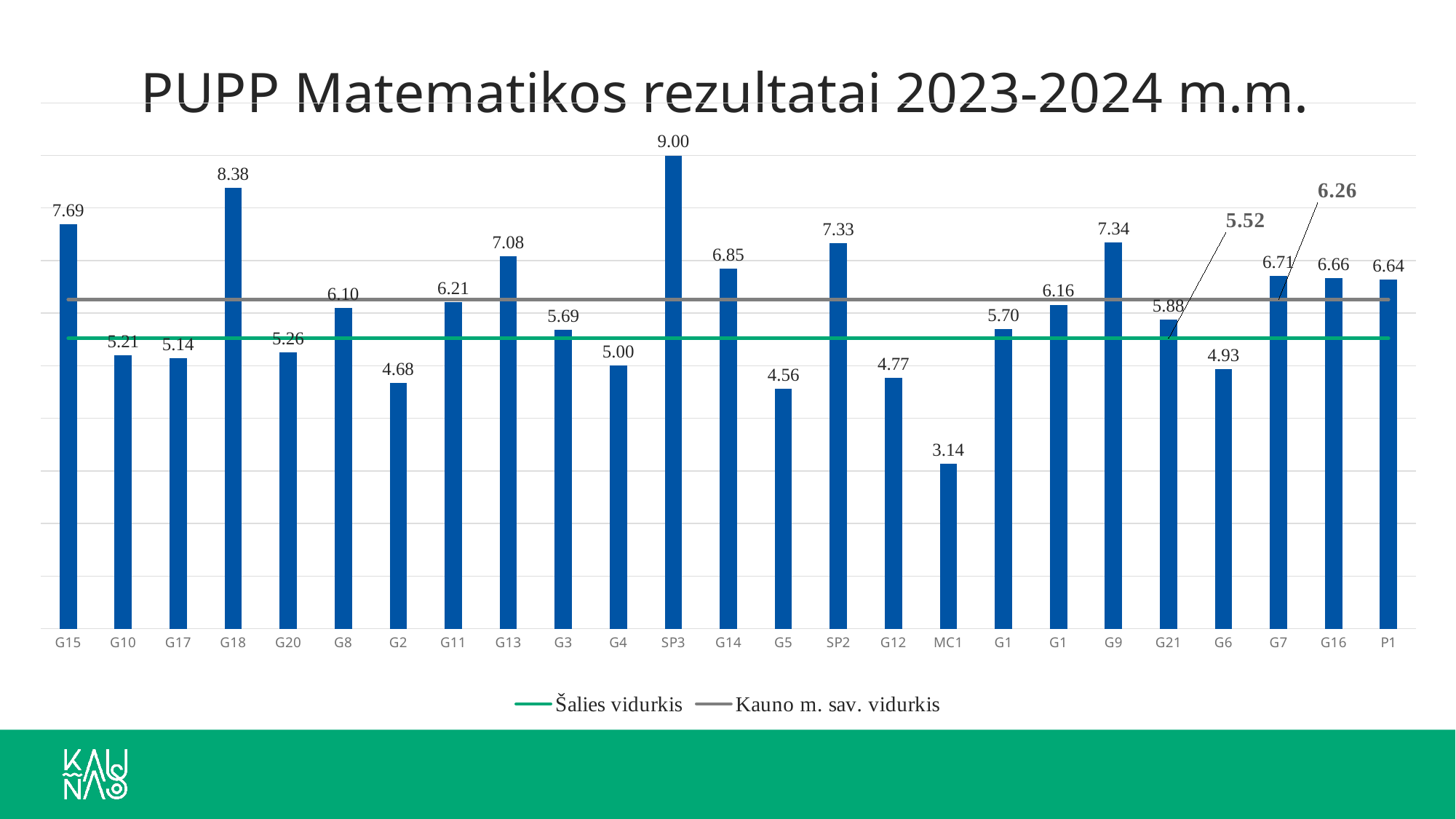
Which is larger, the value for G9 or the value for SP2? G9 What value is labelled for the Šalies vidurkis line? 5.52 How many series does the legend list? 2 What is the difference between the values for G15 and G10? 2.48 How many bars (categories) are shown on the x axis? 25 Which category has the highest value? SP3 What is the title of the chart? PUPP Matematikos rezultatai 2023-2024 m.m. What is the value for G18? 8.38 Which category has the lowest value? MC1 What kind of chart is this? Bar chart What is the value for SP3? 9.00 What is the value for MC1? 3.14